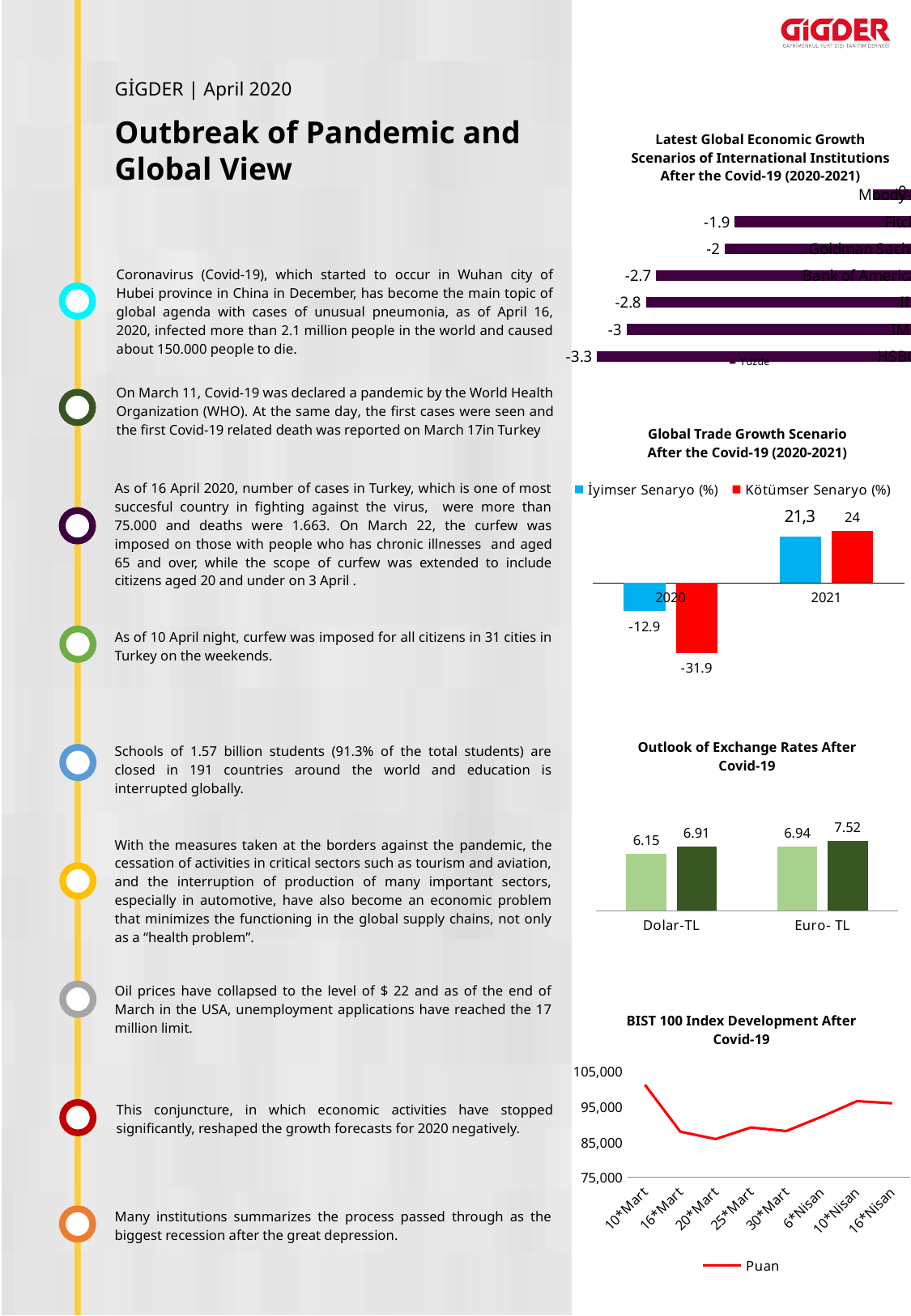
In the 'Outlook of Exchange Rates After Covid-19' chart, what is the difference between the two Dolar-TL values? 0.76 In the 'Global Trade Growth Scenario' chart, how many series does the legend list? 2 In the 'Global Trade Growth Scenario' chart, which is larger for 2020: the İyimser Senaryo value or the Kötümser Senaryo value? İyimser Senaryo (%) In the 'Global Trade Growth Scenario' chart, what is the İyimser Senaryo (%) value for 2021? 21,3 In the 'Latest Global Economic Growth Scenarios' chart, what value is shown for Goldman Sachs? -2 In the 'Latest Global Economic Growth Scenarios' chart, how many institutions are listed? 7 What kind of chart is 'BIST 100 Index Development After Covid-19'? line chart In the 'BIST 100 Index Development After Covid-19' chart, is the value for 10 Mart greater or less than 95,000? greater In the 'Latest Global Economic Growth Scenarios' chart, what value is shown for Fitch? -1.9 In the 'Latest Global Economic Growth Scenarios' chart, which institution has the lowest value? HSBC In the 'Outlook of Exchange Rates After Covid-19' chart, what is the highest value shown for Euro-TL? 7.52 In the 'Global Trade Growth Scenario' chart, what is the Kötümser Senaryo (%) value for 2020? -31.9